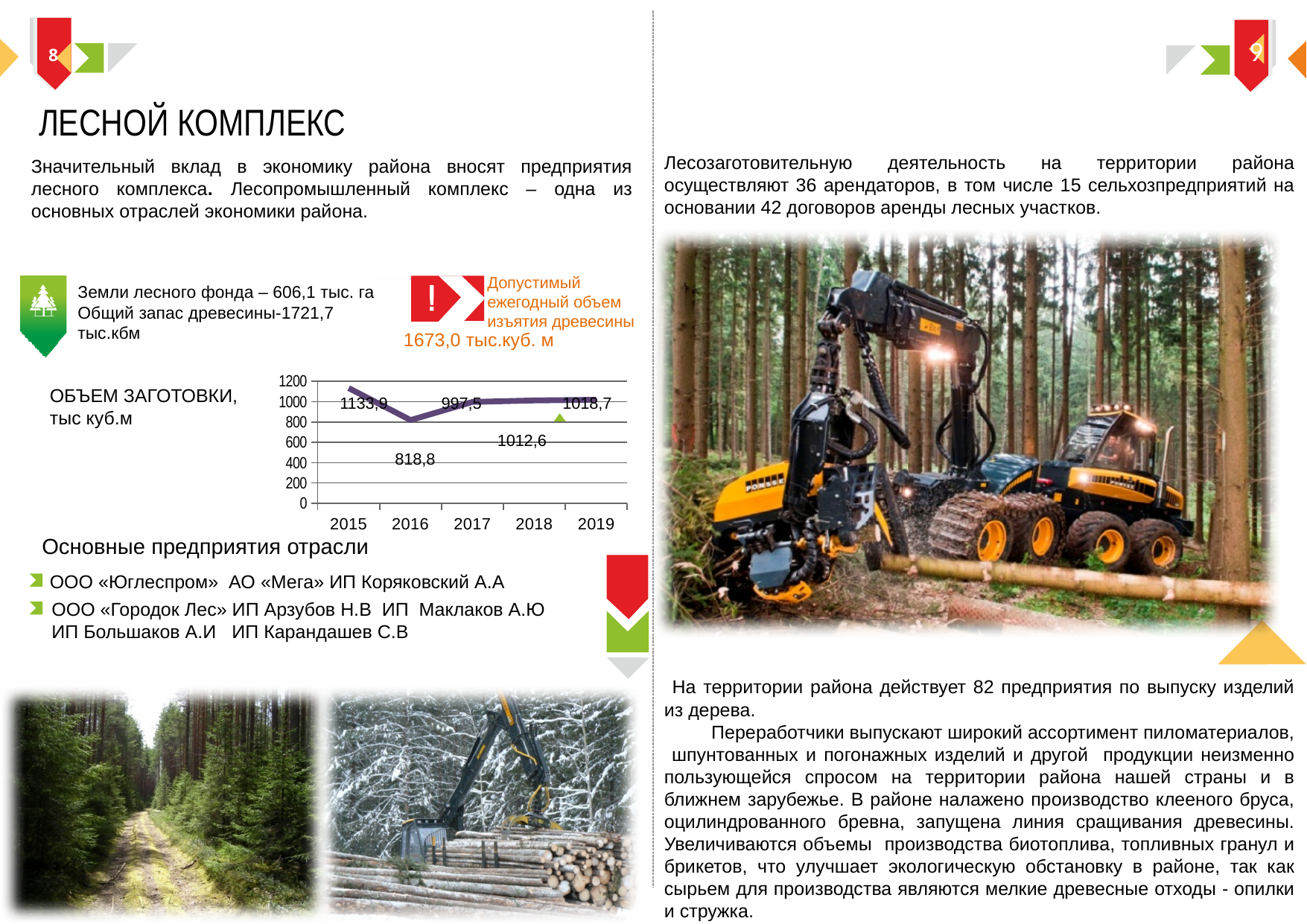
In the ОБЪЕМ ЗАГОТОВКИ chart, is the value for 2016 greater or less than 1000? less Which year has the lowest harvesting volume in the ОБЪЕМ ЗАГОТОВКИ chart? 2016 What is the harvesting volume (ОБЪЕМ ЗАГОТОВКИ) for 2015? 1133,9 What is the harvesting volume (ОБЪЕМ ЗАГОТОВКИ) for 2019? 1018,7 What is the harvesting volume (ОБЪЕМ ЗАГОТОВКИ) for 2017? 997,5 How many years are plotted in the ОБЪЕМ ЗАГОТОВКИ chart? 5 In the ОБЪЕМ ЗАГОТОВКИ chart, do the values rise or fall from 2016 to 2019? rise What is the harvesting volume (ОБЪЕМ ЗАГОТОВКИ) for 2016? 818,8 What is the difference between the harvesting volumes for 2015 and 2016 in the ОБЪЕМ ЗАГОТОВКИ chart? 315,1 What type of chart is used to show the harvesting volume (ОБЪЕМ ЗАГОТОВКИ, тыс куб.м)? Line chart Which year has the highest harvesting volume in the ОБЪЕМ ЗАГОТОВКИ chart? 2015 In the ОБЪЕМ ЗАГОТОВКИ chart, which is larger: the value for 2015 or the value for 2017? 2015